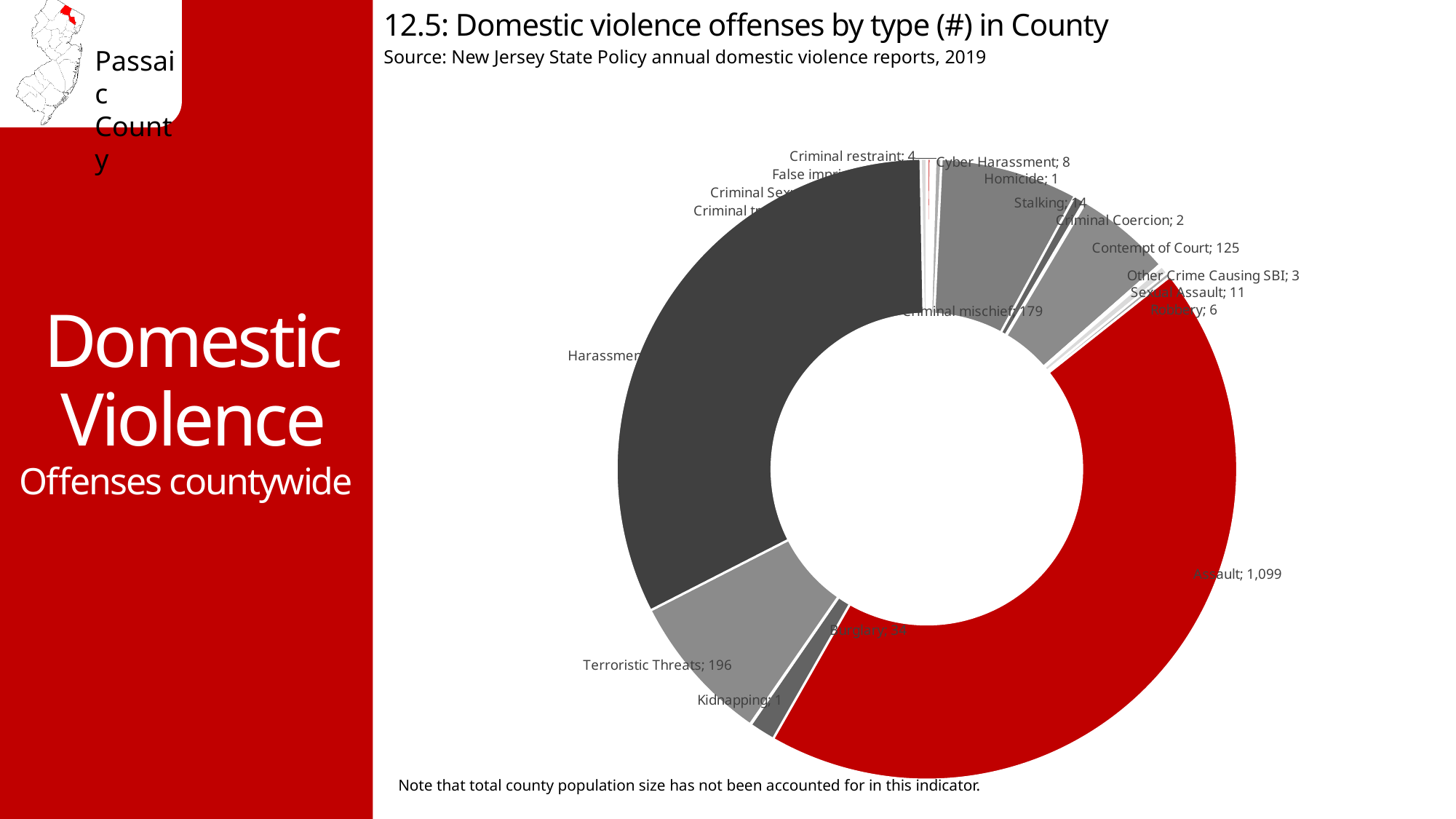
What is the value for Terroristic Threats? 196 What is the value for Contempt of Court? 125 What is the value for Criminal mischief? 179 What is the difference between Terroristic Threats and Criminal mischief? 17 What type of chart is shown on the slide? Pie (donut) chart Which offense type has the largest slice in the chart? Assault Which is larger, Terroristic Threats or Contempt of Court? Terroristic Threats What is the value for Cyber Harassment? 8 What is the difference between Contempt of Court and Sexual Assault? 114 How many domestic violence offenses of type Assault are shown? 1,099 What is the value for Sexual Assault? 11 What is the source cited for the chart? New Jersey State Policy annual domestic violence reports, 2019